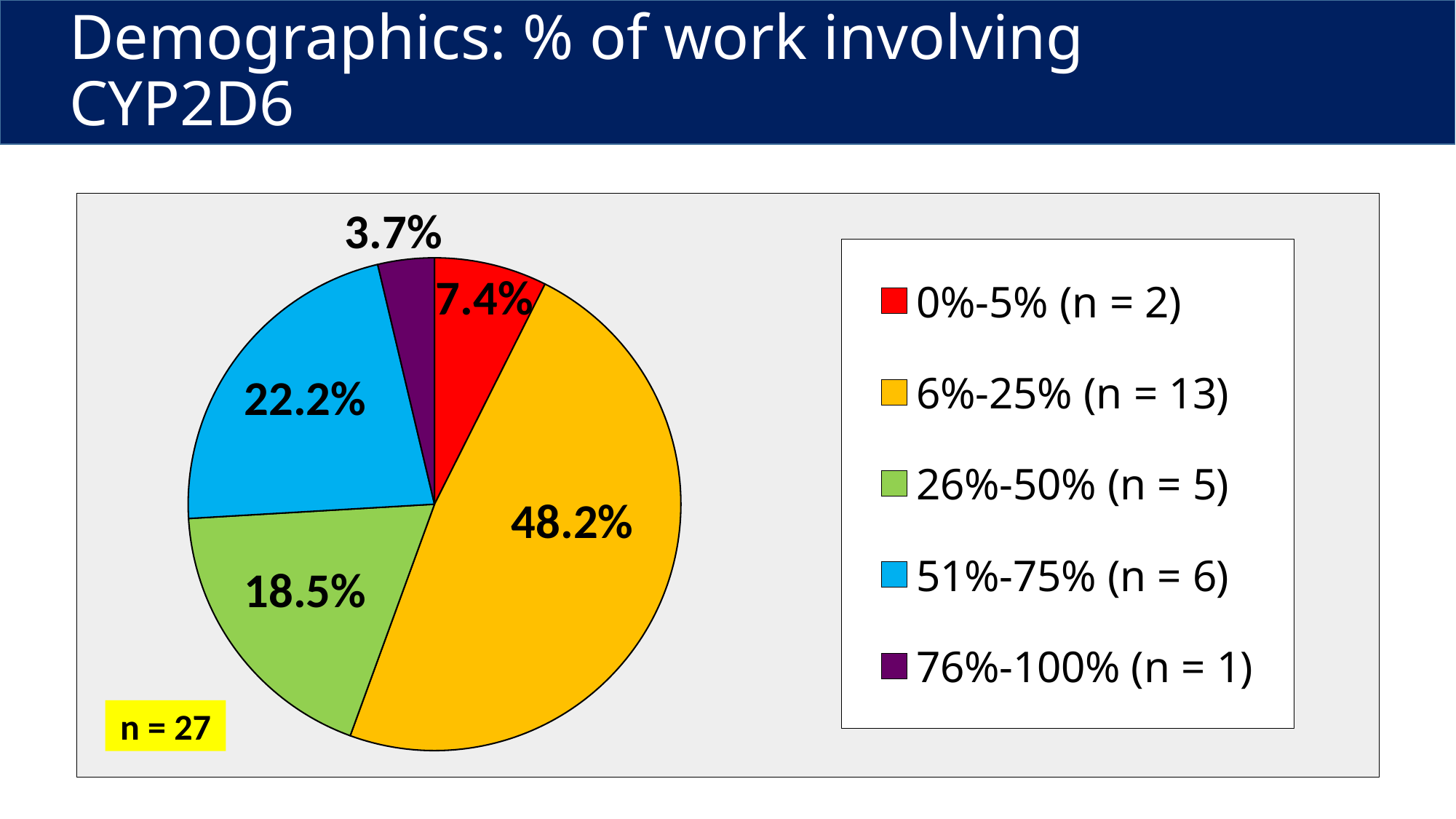
What is the difference in percentage points between the 51%-75% slice and the 26%-50% slice? 3.7 What is the total sample size (n) shown on the chart? n = 27 What share of the pie does the 6%-25% category represent? 48.2% How many categories does the pie chart have? 5 What share of the pie does the 51%-75% category represent? 22.2% What share of the pie does the 0%-5% category represent? 7.4% What kind of chart is shown on the slide? pie chart Which category has the largest slice of the pie? 6%-25% Which category has the smallest slice of the pie? 76%-100% Which slice is larger, 0%-5% or 26%-50%? 26%-50%